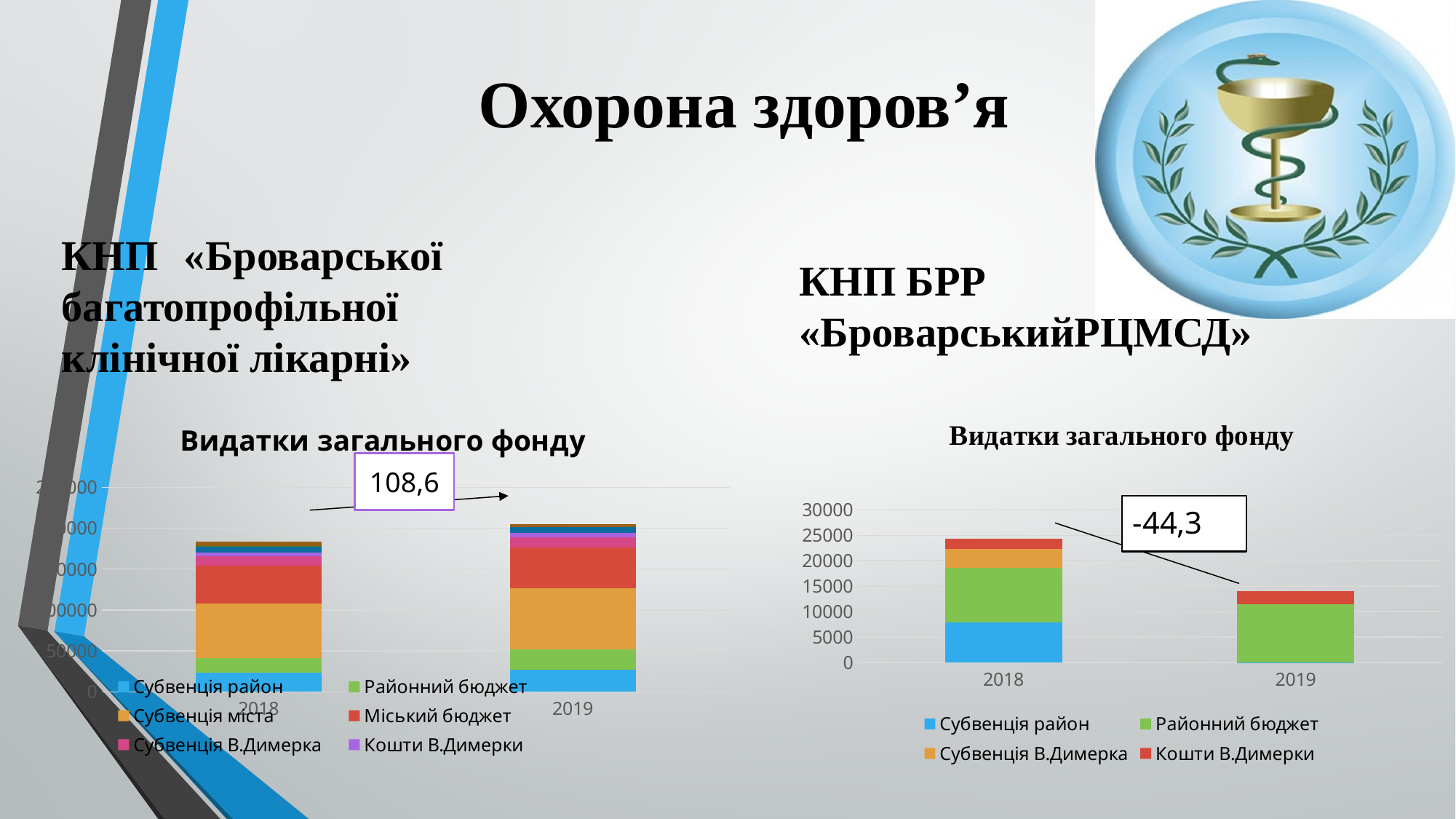
What value is shown in the annotation box in the right chart? -44,3 In the right chart, which year has the taller stacked bar, 2018 or 2019? 2018 What kind of chart is the left chart (under «Броварської багатопрофільної клінічної лікарні»)? bar chart In the right chart, is the total of the 2018 bar greater or less than 20000? greater What value is shown in the annotation box above the bars in the left chart? 108,6 How many years are shown on the x axis of the left chart? 2 How many series does the legend of the right chart list? 4 In the left chart, which year has the taller stacked bar, 2018 or 2019? 2019 In the left chart, do the total expenditures rise or fall from 2018 to 2019? rise What kind of chart is the right chart (under КНП БРР «БроварськийРЦМСД»)? bar chart In the right chart, is the total of the 2019 bar greater or less than 20000? less How many series does the legend of the left chart list? 6